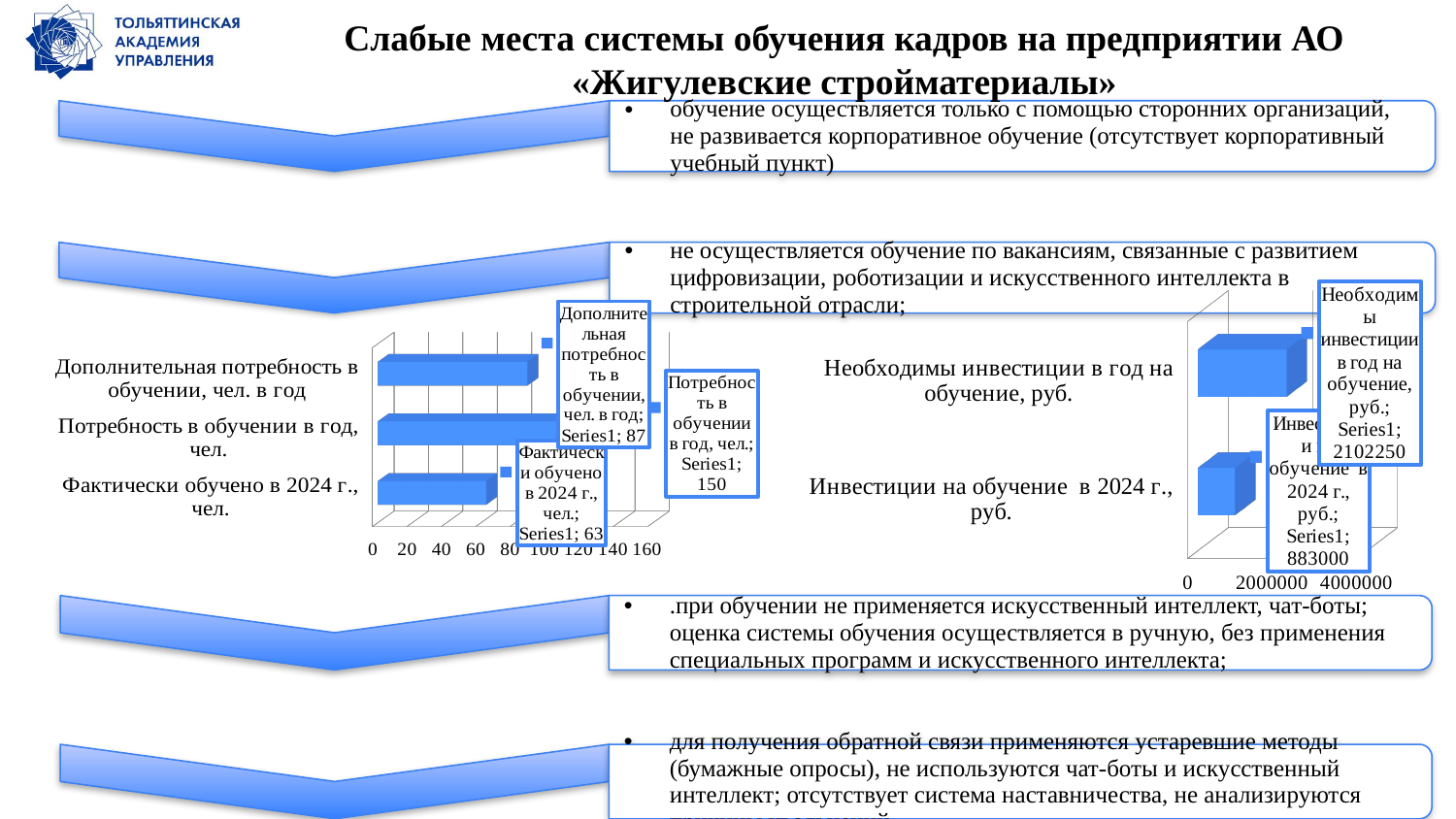
On the left chart, which category has the lowest value? Фактически обучено в 2024 г., чел. What kind of chart is the right chart? bar chart On the left chart, what is the value for 'Потребность в обучении в год, чел.'? 150 On the left chart, what is the value for 'Фактически обучено в 2024 г., чел.'? 63 On the left chart, what is the difference between 'Потребность в обучении в год, чел.' and 'Фактически обучено в 2024 г., чел.'? 87 On the left chart, what is the value for 'Дополнительная потребность в обучении, чел. в год'? 87 On the right chart, what is the difference between 'Необходимы инвестиции в год на обучение, руб.' and 'Инвестиции на обучение в 2024 г., руб.'? 1219250 On the right chart, what is the value for 'Необходимы инвестиции в год на обучение, руб.'? 2102250 On the left chart, how many categories are plotted? 3 On the left chart, which category has the highest value? Потребность в обучении в год, чел. On the right chart, is the value for 'Инвестиции на обучение в 2024 г., руб.' greater or less than 2000000? less On the right chart, what is the value for 'Инвестиции на обучение в 2024 г., руб.'? 883000